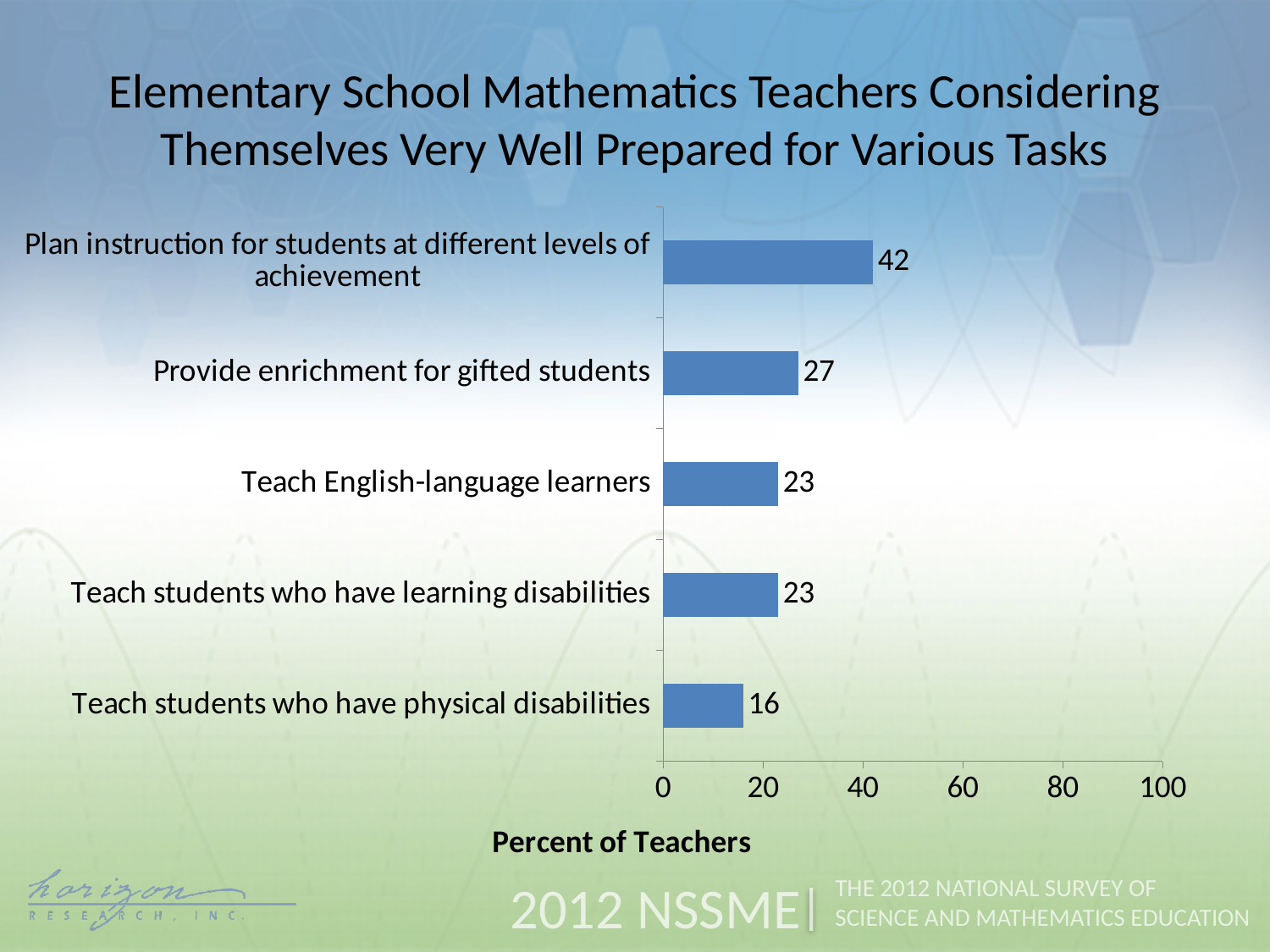
What kind of chart is shown on the slide? Bar chart What is the difference between the values for 'Plan instruction for students at different levels of achievement' and 'Provide enrichment for gifted students'? 15 What is the label of the horizontal axis? Percent of Teachers Which task has the lowest percent of teachers considering themselves very well prepared? Teach students who have physical disabilities What is the value for 'Teach English-language learners'? 23 Which is larger: the value for 'Provide enrichment for gifted students' or 'Teach students who have learning disabilities'? Provide enrichment for gifted students What is the value for 'Teach students who have physical disabilities'? 16 What is the value for 'Provide enrichment for gifted students'? 27 Is the value for 'Plan instruction for students at different levels of achievement' greater or less than 40? greater How many tasks (categories) are shown in the chart? 5 Which task has the highest percent of teachers considering themselves very well prepared? Plan instruction for students at different levels of achievement What percent of teachers consider themselves very well prepared to plan instruction for students at different levels of achievement? 42